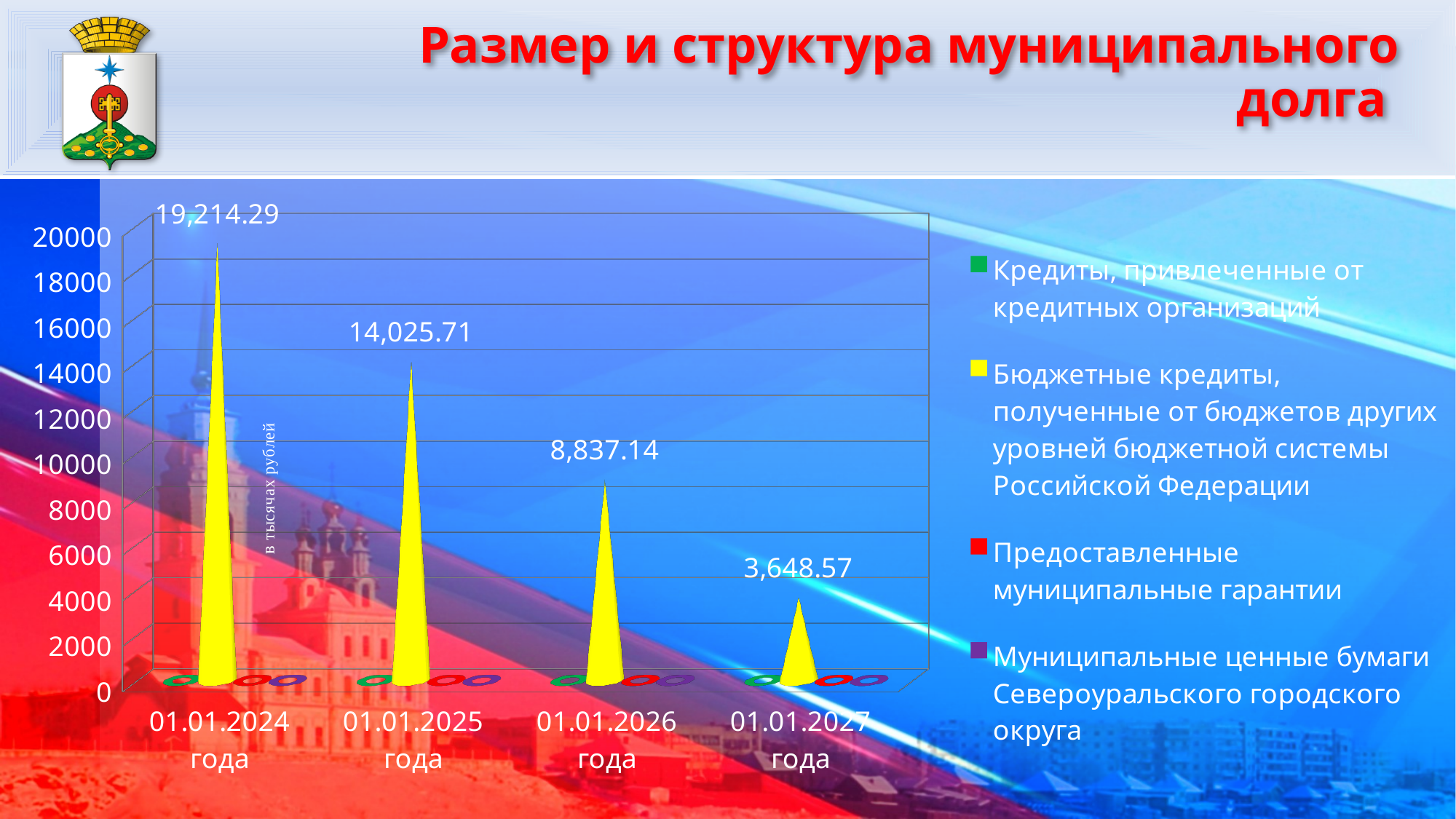
What is the value of budget credits on 01.01.2025? 14,025.71 What is the value of budget credits (Бюджетные кредиты) on 01.01.2024? 19,214.29 How many dates (categories) are shown on the x axis? 4 What is the difference between the budget credits values on 01.01.2024 and 01.01.2027? 15,565.72 Do the budget credits values rise or fall from 01.01.2024 to 01.01.2027? fall Which is larger: the budget credits value on 01.01.2025 or on 01.01.2026? 01.01.2025 How many series does the legend list? 4 On which date is the budget credits value highest? 01.01.2024 года What is the difference between the budget credits values on 01.01.2024 and 01.01.2025? 5,188.58 On which date is the budget credits value lowest? 01.01.2027 года What is the value of budget credits on 01.01.2026? 8,837.14 What is the value of budget credits on 01.01.2027? 3,648.57